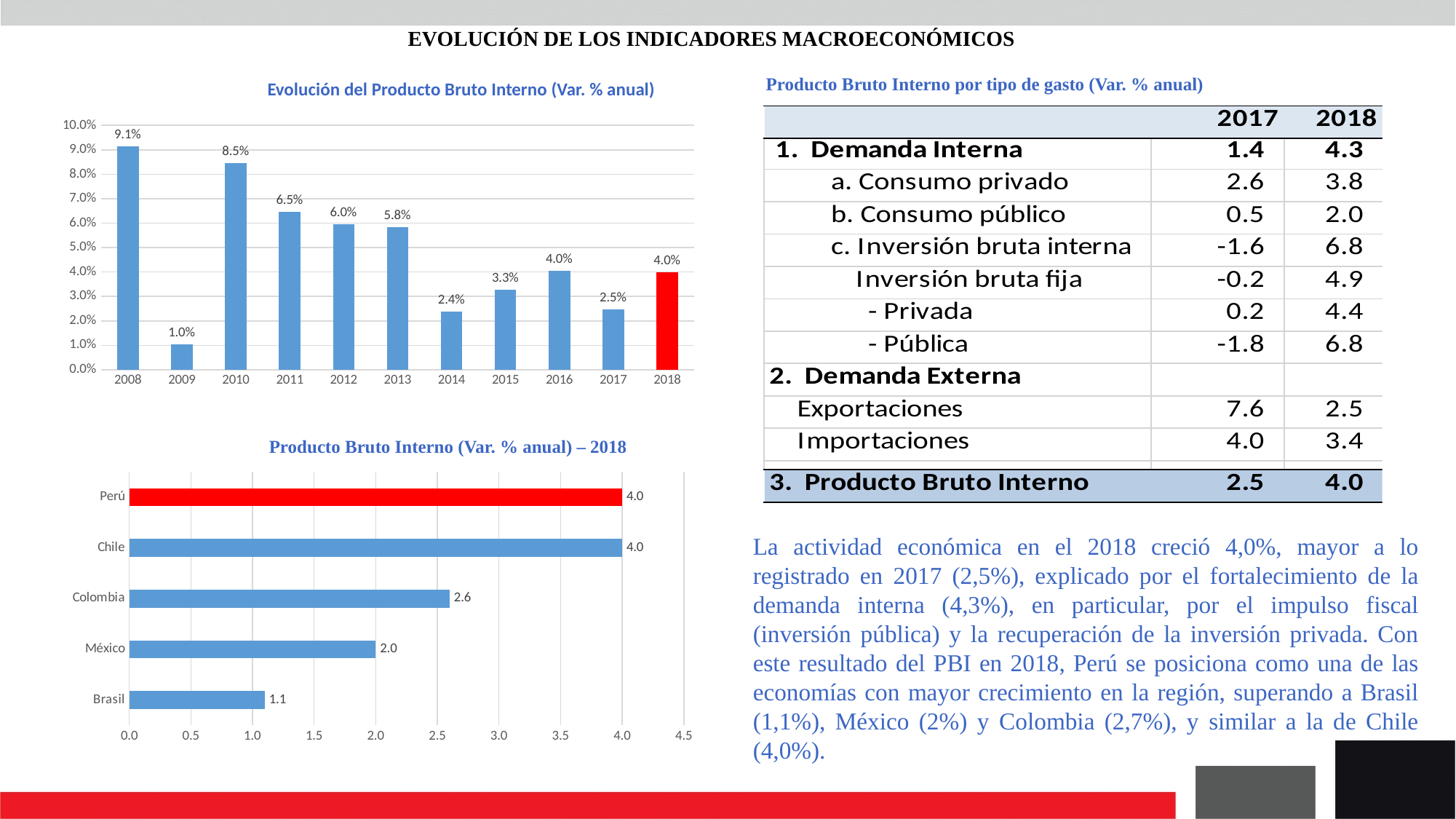
In the 'Evolución del Producto Bruto Interno (Var. % anual)' chart, which year has the lowest value? 2009 In the 'Producto Bruto Interno (Var. % anual) – 2018' chart, which country has the lowest value? Brasil In the 'Producto Bruto Interno (Var. % anual) – 2018' chart, how many countries are shown? 5 In the 'Producto Bruto Interno (Var. % anual) – 2018' chart, what is the difference between the values for Perú and México? 2.0 What kind of chart is the 'Producto Bruto Interno (Var. % anual) – 2018' chart? Bar chart In the 'Evolución del Producto Bruto Interno (Var. % anual)' chart, what is the difference between the values for 2018 and 2017? 1.5% In the 'Evolución del Producto Bruto Interno (Var. % anual)' chart, which year has the highest value? 2008 In the 'Evolución del Producto Bruto Interno (Var. % anual)' chart, which bar is coloured red? 2018 In the 'Producto Bruto Interno (Var. % anual) – 2018' chart, what is the value for Colombia? 2.6 In the 'Evolución del Producto Bruto Interno (Var. % anual)' chart, how many years are shown? 11 In the 'Evolución del Producto Bruto Interno (Var. % anual)' chart, which is larger, the value for 2012 or the value for 2013? 2012 In the 'Evolución del Producto Bruto Interno (Var. % anual)' chart, what is the value for 2010? 8.5%